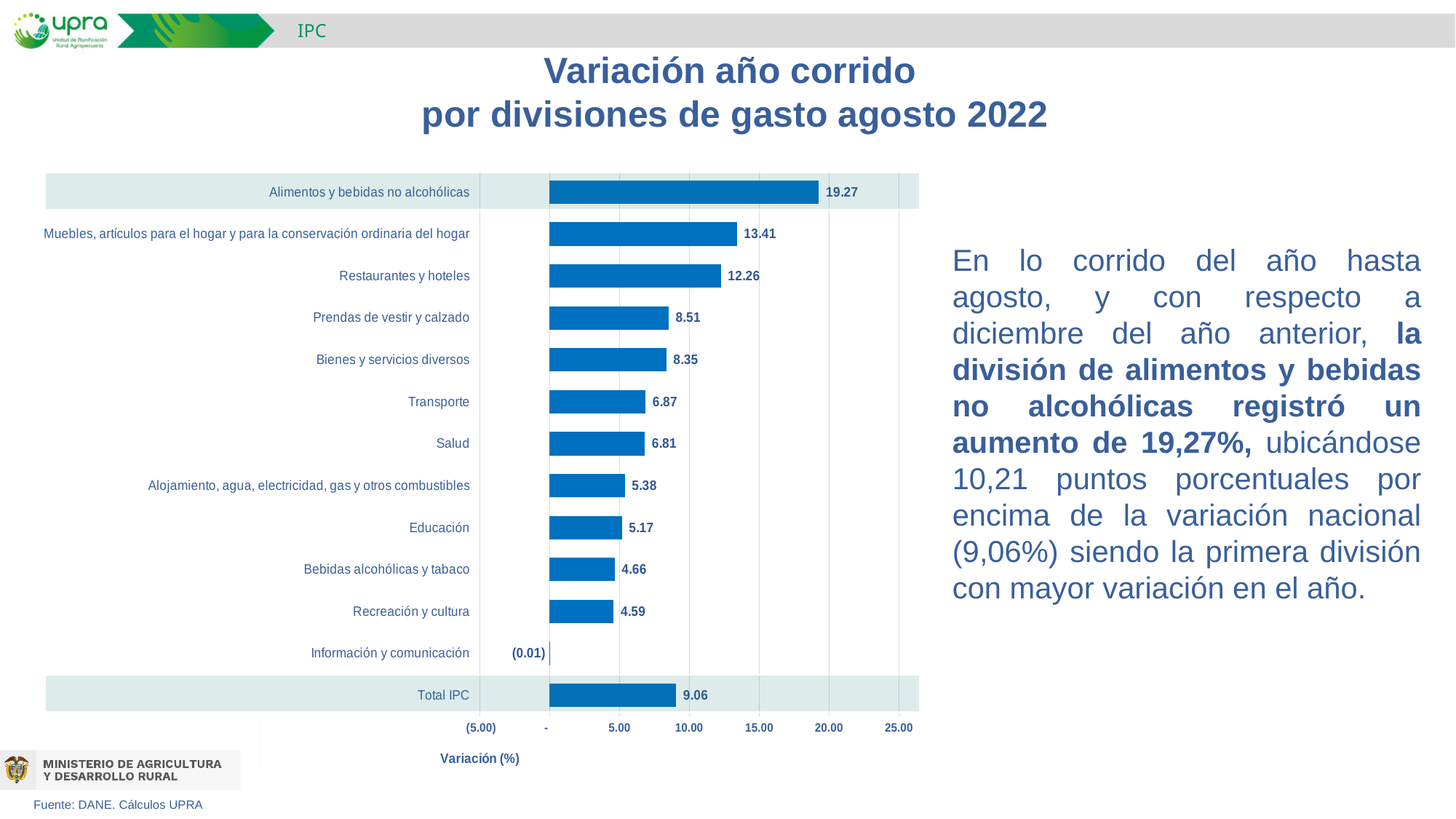
What is the value for Total IPC? 9.06 What is the difference between Muebles, artículos para el hogar y para la conservación ordinaria del hogar and Restaurantes y hoteles? 1.15 Which category has the lowest value? Información y comunicación Which division has the highest variation? Alimentos y bebidas no alcohólicas What is the value for Alimentos y bebidas no alcohólicas? 19.27 What is the value for Información y comunicación? (0.01) Which is larger, Prendas de vestir y calzado or Bienes y servicios diversos? Prendas de vestir y calzado What is the difference between Alimentos y bebidas no alcohólicas and Total IPC? 10.21 How many categories are shown on the chart, including Total IPC? 13 What kind of chart is shown on the slide? Bar chart Is the value for Educación greater or less than 5.00? greater What is the value for Transporte? 6.87